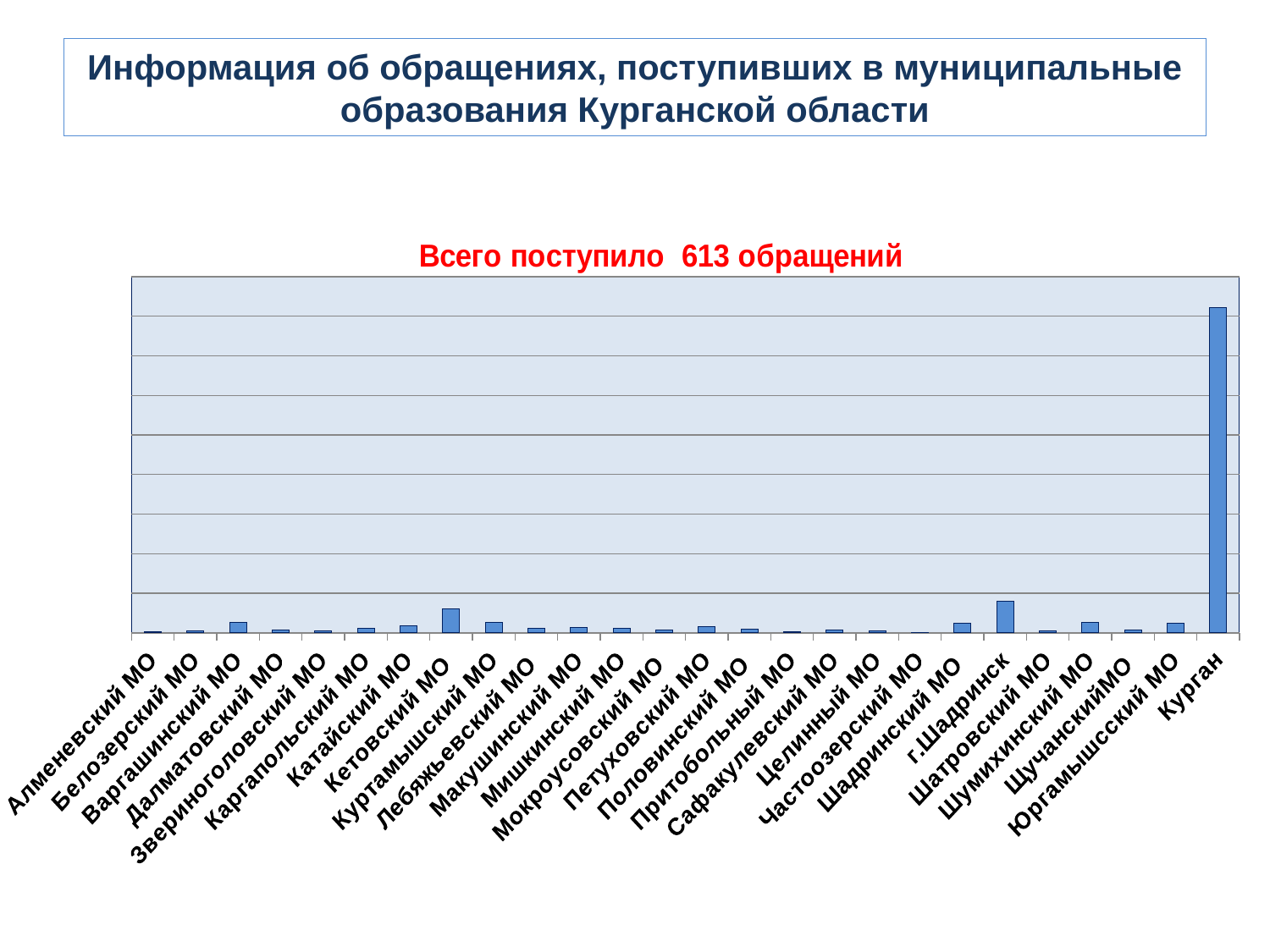
Which bar is taller, Кетовский МО or Куртамышский МО? Кетовский МО Which bar is taller, г.Шадринск or Кетовский МО? г.Шадринск What kind of chart is shown on the slide? bar chart Which municipality has the highest bar in the chart? Курган Which bar is taller, Варгашинский МО or Белозерский МО? Варгашинский МО Which municipality has the second-highest bar in the chart? г.Шадринск How many municipalities (categories) are shown on the x axis? 26 What is the title printed directly above the chart? Всего поступило 613 обращений According to the chart heading, how many appeals were received in total? 613